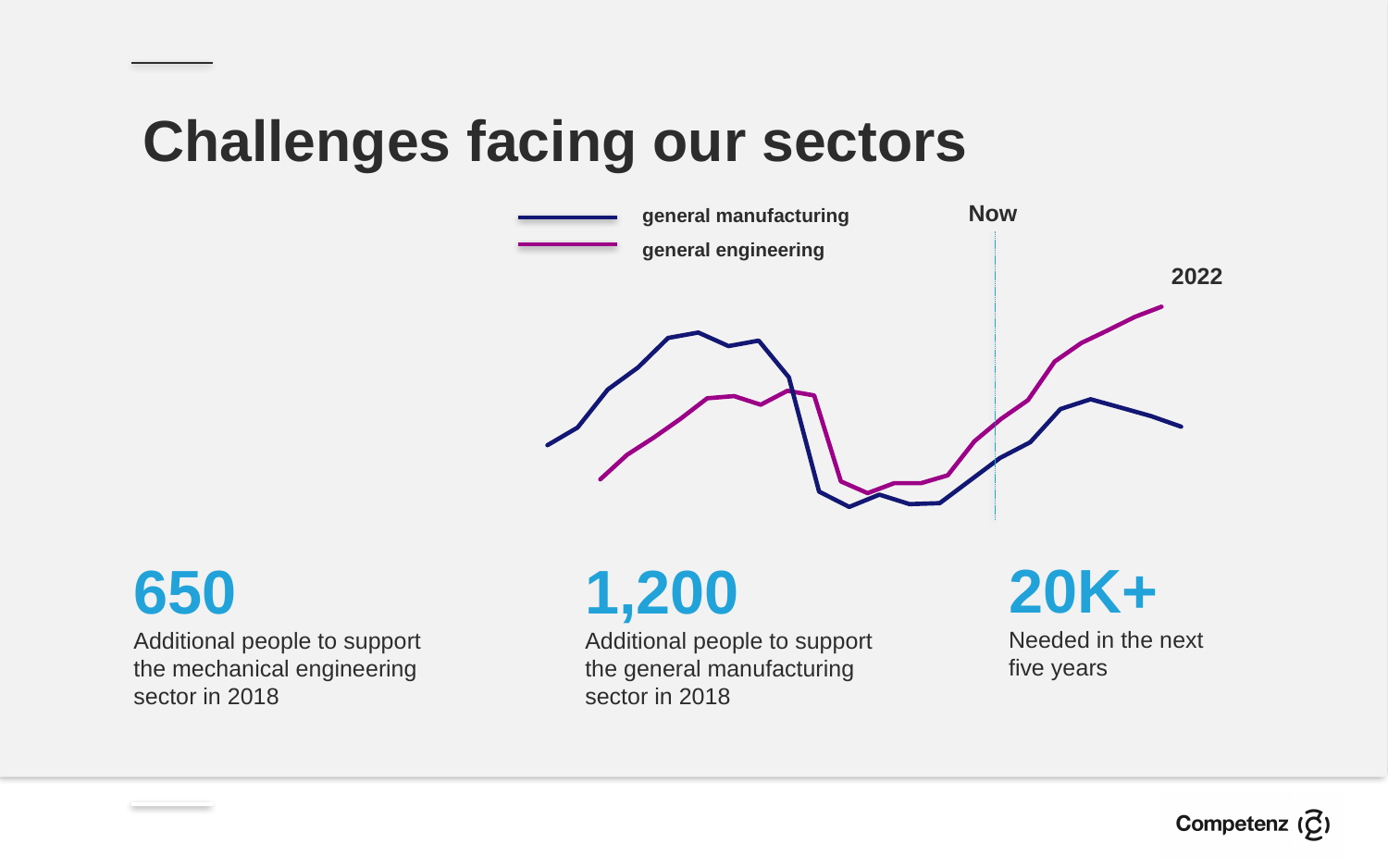
At the right end of the chart (2022), which line is higher: general manufacturing or general engineering? general engineering Does the general engineering line rise or fall between the 'Now' marker and 2022? rise Which colour is used for the general engineering line? magenta (purple) At the left start of the chart, which line is higher: general manufacturing or general engineering? general manufacturing Which series reaches the highest point on the chart? general engineering Does the general manufacturing line rise or fall over the final segment leading to 2022? fall How many series does the chart's legend list? 2 What kind of chart is shown on the slide? line chart What are the two series named in the chart's legend? general manufacturing and general engineering Which series is higher at the 'Now' marker? general engineering Which series reaches the lowest point on the chart? general manufacturing